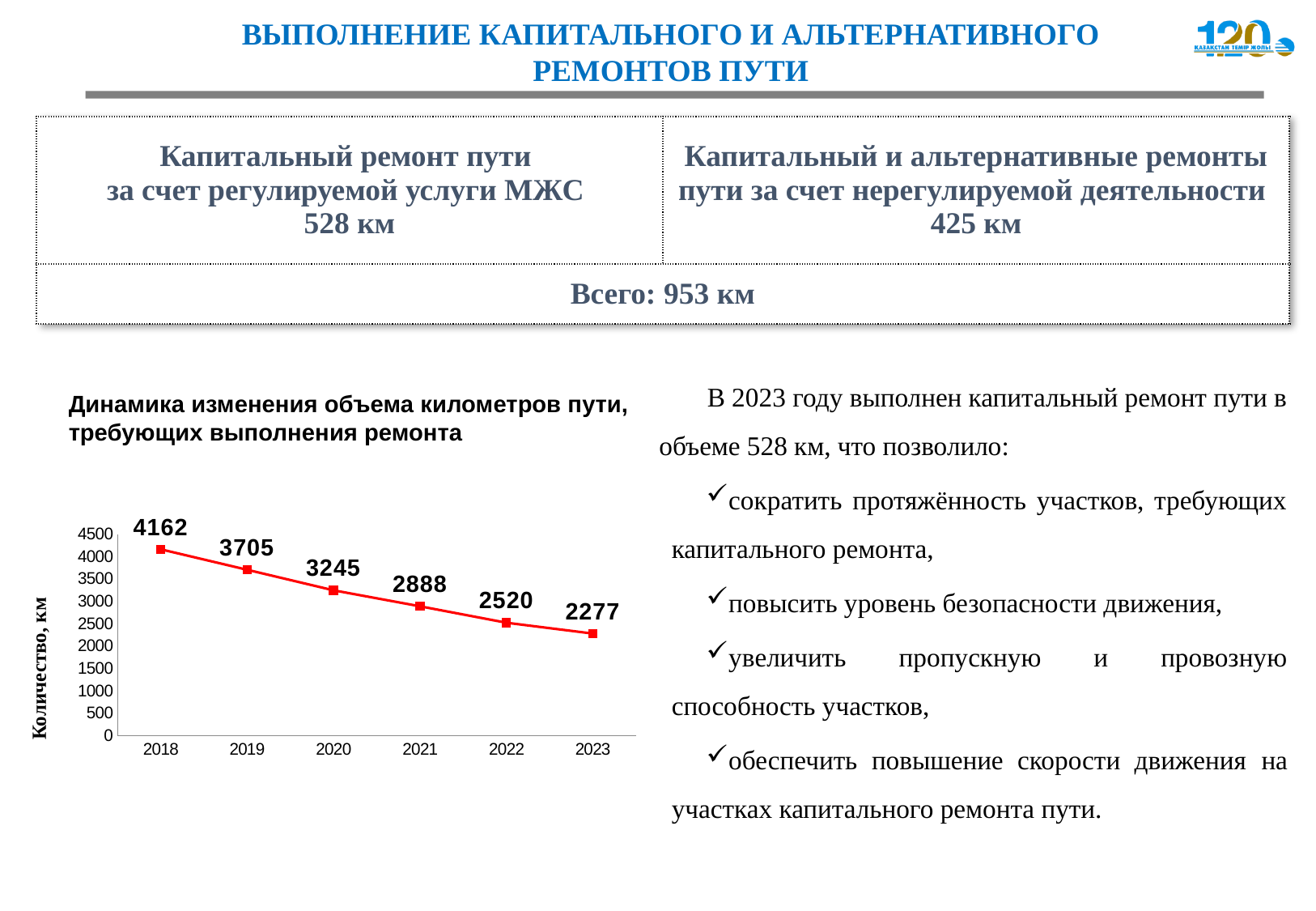
Is the value for 2022 in the line chart greater or less than 3000? less How many years are plotted in the line chart? 6 What is the difference between the values for 2018 and 2023 in the line chart? 1885 Which year has the lowest value in the line chart? 2023 What is the value for 2021 in the line chart? 2888 What is the difference between the values for 2019 and 2020 in the line chart? 460 What is the value for 2018 in the line chart? 4162 What kind of chart is shown on the slide? line chart Do the values in the line chart rise or fall from 2018 to 2023? fall Which year has the highest value in the line chart? 2018 Which is larger in the line chart, the value for 2020 or the value for 2022? 2020 What is the value for 2023 in the line chart? 2277